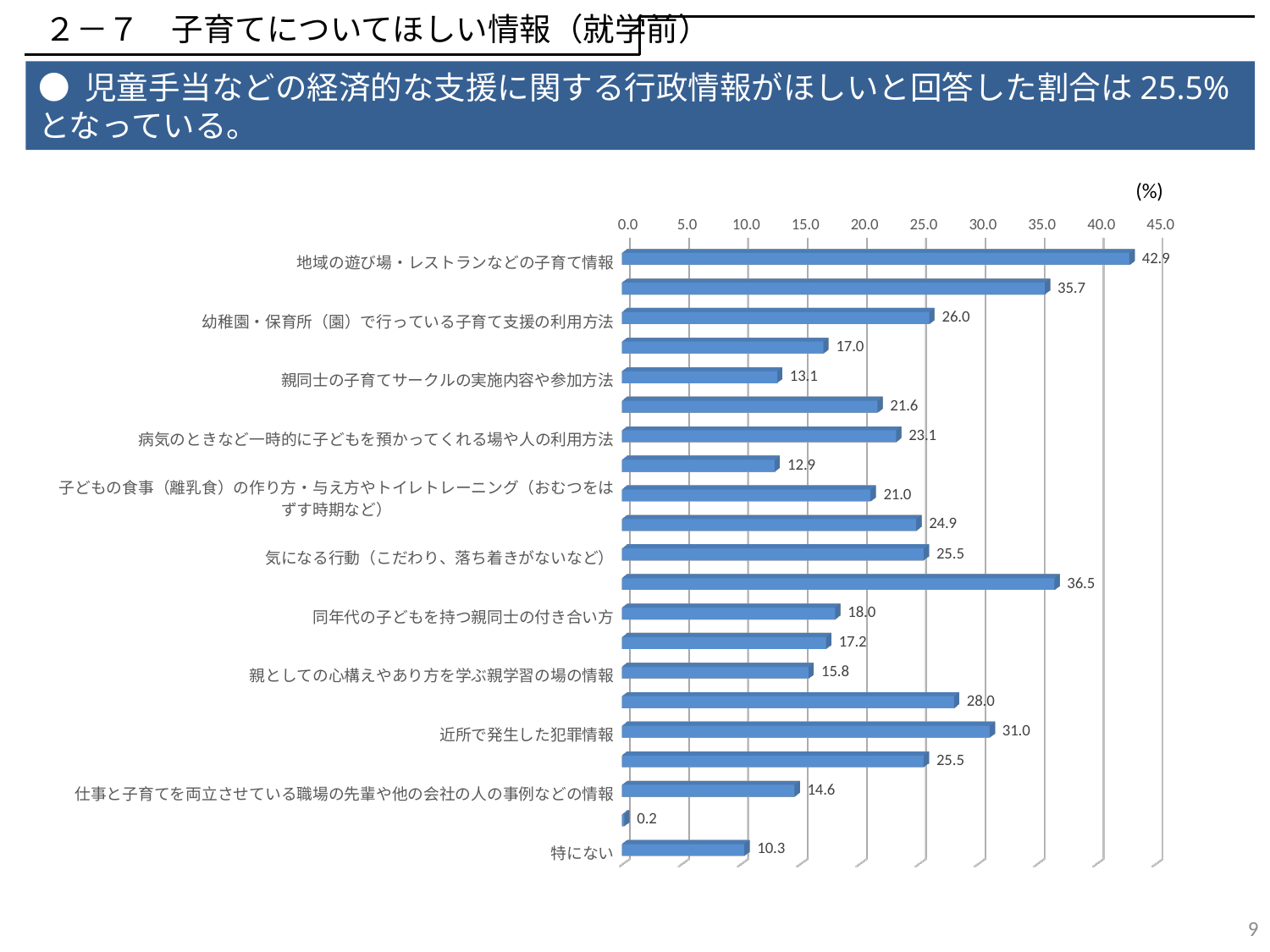
What is the value for 特にない? 10.3 What type of chart is shown on the slide? bar chart What is the value for 親同士の子育てサークルの実施内容や参加方法? 13.1 What is the value for 気になる行動（こだわり、落ち着きがないなど）? 25.5 What is the difference between the values for 地域の遊び場・レストランなどの子育て情報 and 近所で発生した犯罪情報? 11.9 What is the smallest value printed on the chart? 0.2 Which is larger, the value for 幼稚園・保育所（園）で行っている子育て支援の利用方法 or the value for 病気のときなど一時的に子どもを預かってくれる場や人の利用方法? 幼稚園・保育所（園）で行っている子育て支援の利用方法 Which category has the highest value? 地域の遊び場・レストランなどの子育て情報 How many bars are plotted on the chart? 21 What is the value for 地域の遊び場・レストランなどの子育て情報? 42.9 What is the value for 近所で発生した犯罪情報? 31.0 What unit is indicated at the top right of the chart's axis? (%)